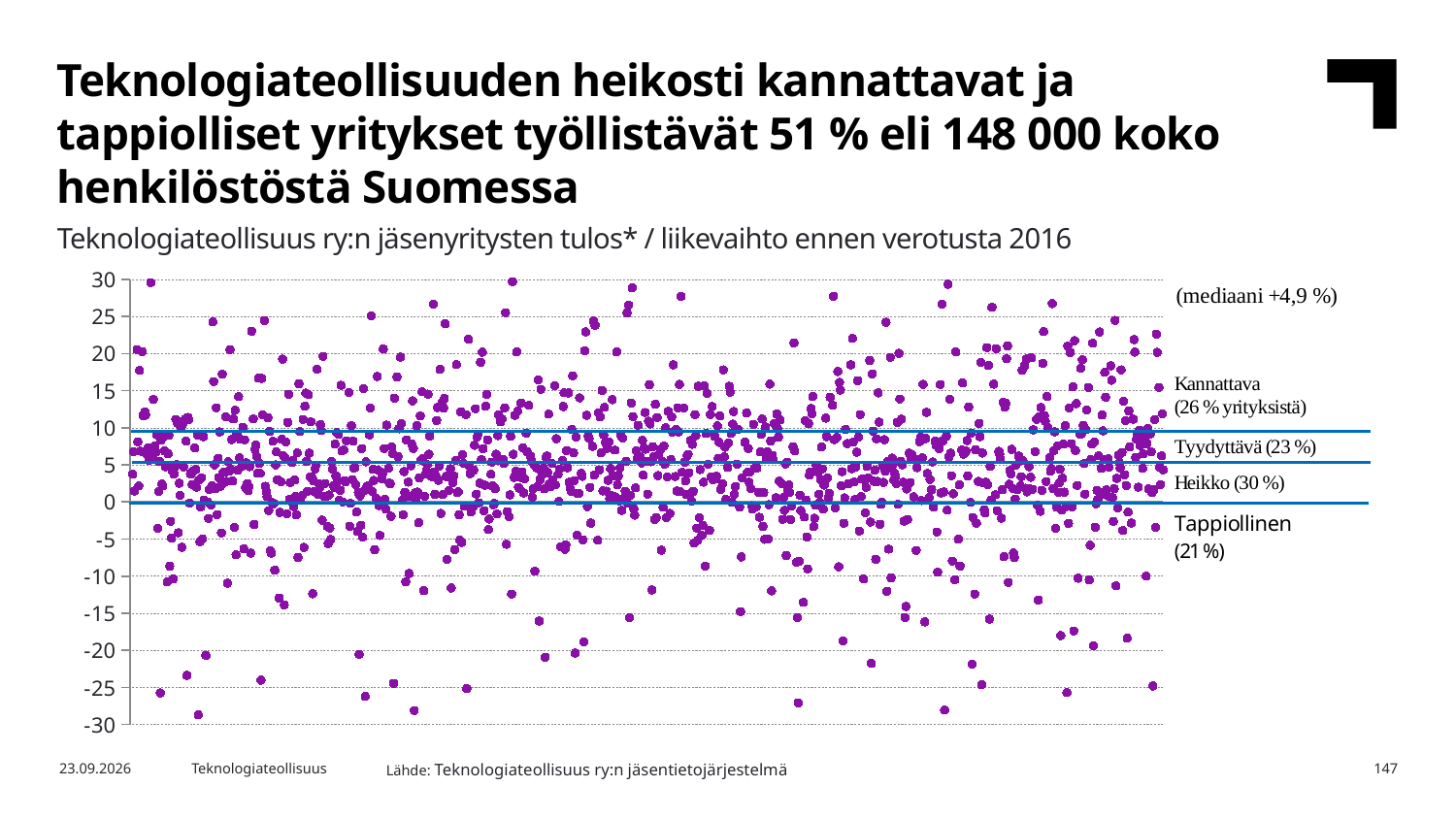
How many percentage points larger is the Kannattava share than the Tappiollinen share? 5 What is the highest value shown on the vertical axis? 30 Which share is larger, Heikko or Tyydyttävä? Heikko What share of companies is labelled as Heikko on the chart? 30 % What kind of chart is shown on the slide? Scatter chart What median value is stated on the chart? +4,9 % Which of the four profitability categories has the smallest share of companies? Tappiollinen What share of companies is labelled as Kannattava on the chart? 26 % What year does the chart subtitle refer to? 2016 What share of companies is labelled as Tyydyttävä on the chart? 23 % Which of the four profitability categories has the largest share of companies? Heikko What share of companies is labelled as Tappiollinen on the chart? 21 %